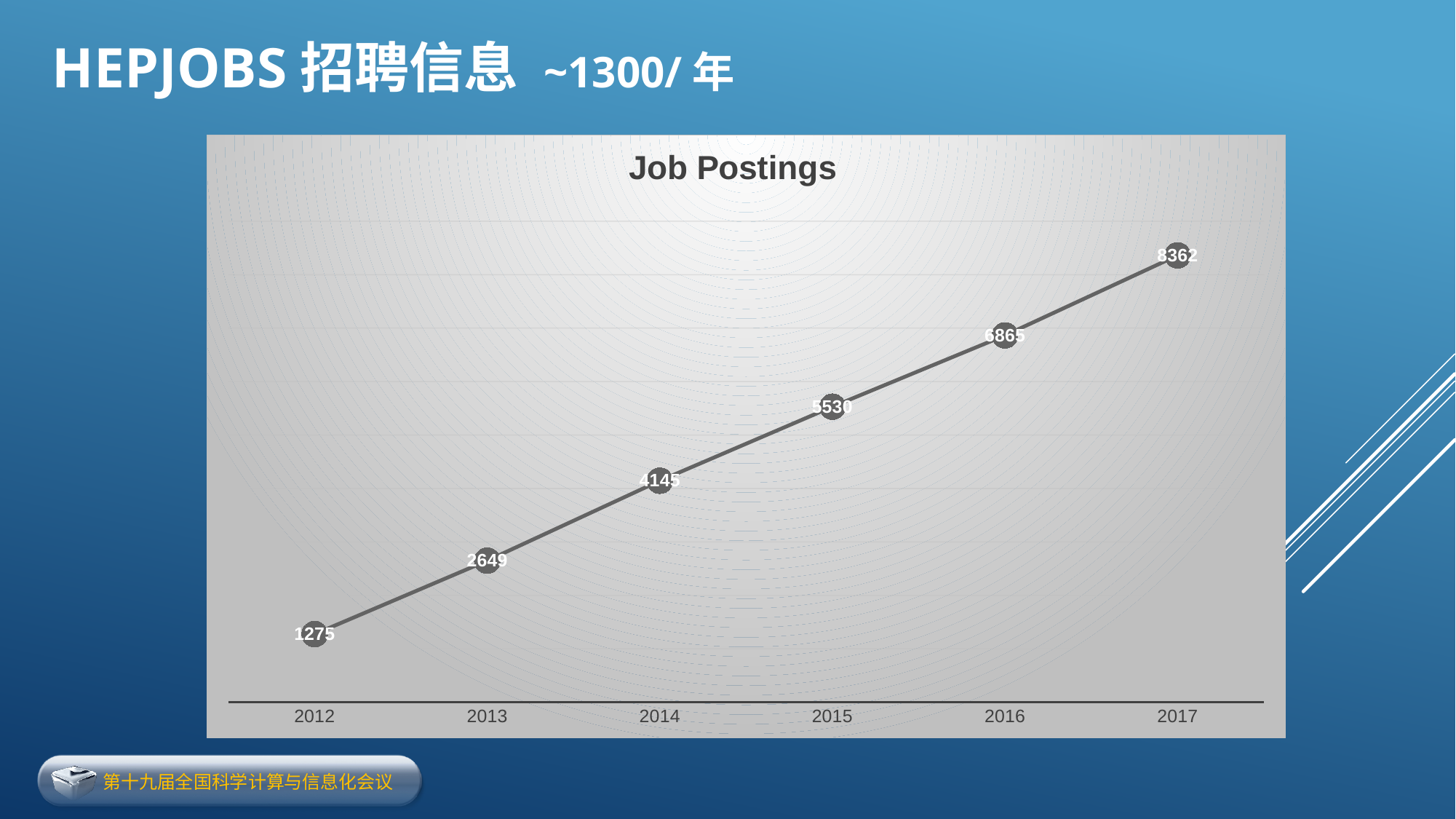
What is the value for 2012? 1275 How many years are plotted on the x axis? 6 What is the value for 2017? 8362 Which year has the lowest value? 2012 Which year has the highest value? 2017 What is the value for 2014? 4145 Which is larger, the value for 2015 or the value for 2014? 2015 What is the value for 2016? 6865 What is the difference between the values for 2013 and 2012? 1374 Do the values rise or fall from 2012 to 2017? rise What is the difference between the values for 2017 and 2016? 1497 What kind of chart is this? line chart